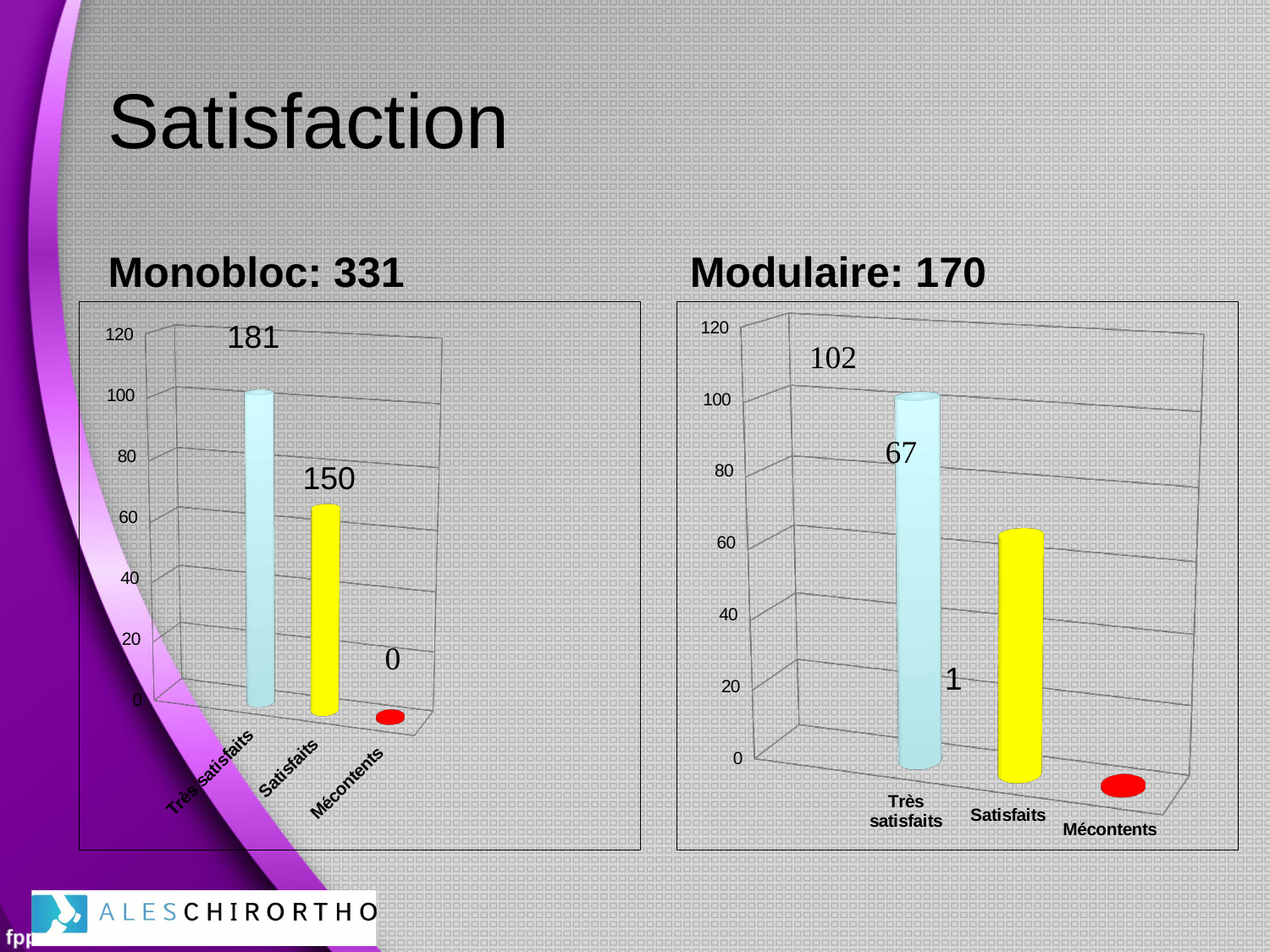
In the Modulaire: 170 chart, what is the value for Satisfaits? 67 In the Monobloc: 331 chart, which category has the highest value? Très satisfaits How many categories are shown in the Modulaire: 170 chart? 3 In the Monobloc: 331 chart, what is the value for Satisfaits? 150 In the Modulaire: 170 chart, what is the difference between Très satisfaits and Satisfaits? 35 In the Modulaire: 170 chart, which category has the lowest value? Mécontents In the Modulaire: 170 chart, what is the value for Très satisfaits? 102 In the Monobloc: 331 chart, what is the difference between Très satisfaits and Satisfaits? 31 In the Modulaire: 170 chart, what is the value for Mécontents? 1 Which is larger: Satisfaits in the Monobloc: 331 chart or Très satisfaits in the Modulaire: 170 chart? Satisfaits in the Monobloc: 331 chart In the Monobloc: 331 chart, what is the value for Mécontents? 0 In the Monobloc: 331 chart, what is the value for Très satisfaits? 181